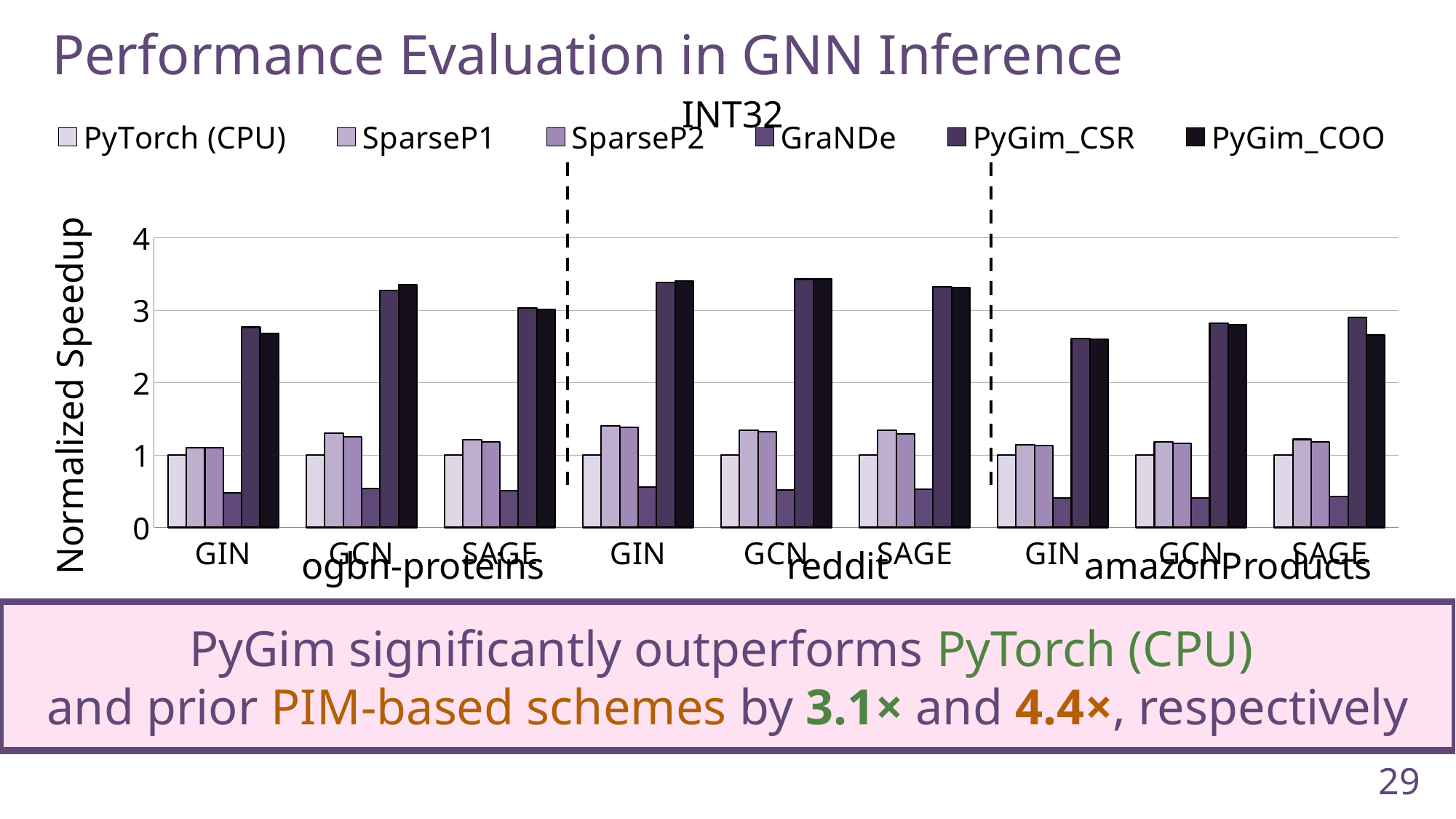
Is the value for PyGim_CSR on reddit GCN greater or less than 3? greater What kind of chart is shown on the slide? bar chart For GIN on ogbn-proteins, which is larger: PyGim_CSR or SparseP1? PyGim_CSR How many model categories (bar groups) are plotted along the x axis? 9 Is the value for PyGim_CSR on amazonProducts GIN greater or less than 3? less How many series does the legend list? 6 Is the value for SparseP1 on ogbn-proteins GCN greater or less than 1? greater What is the normalized speedup of PyTorch (CPU) for GIN on ogbn-proteins? 1 What is the title shown above the chart? INT32 Which series has the lowest normalized speedup for SAGE on amazonProducts? GraNDe What is the label of the y axis? Normalized Speedup